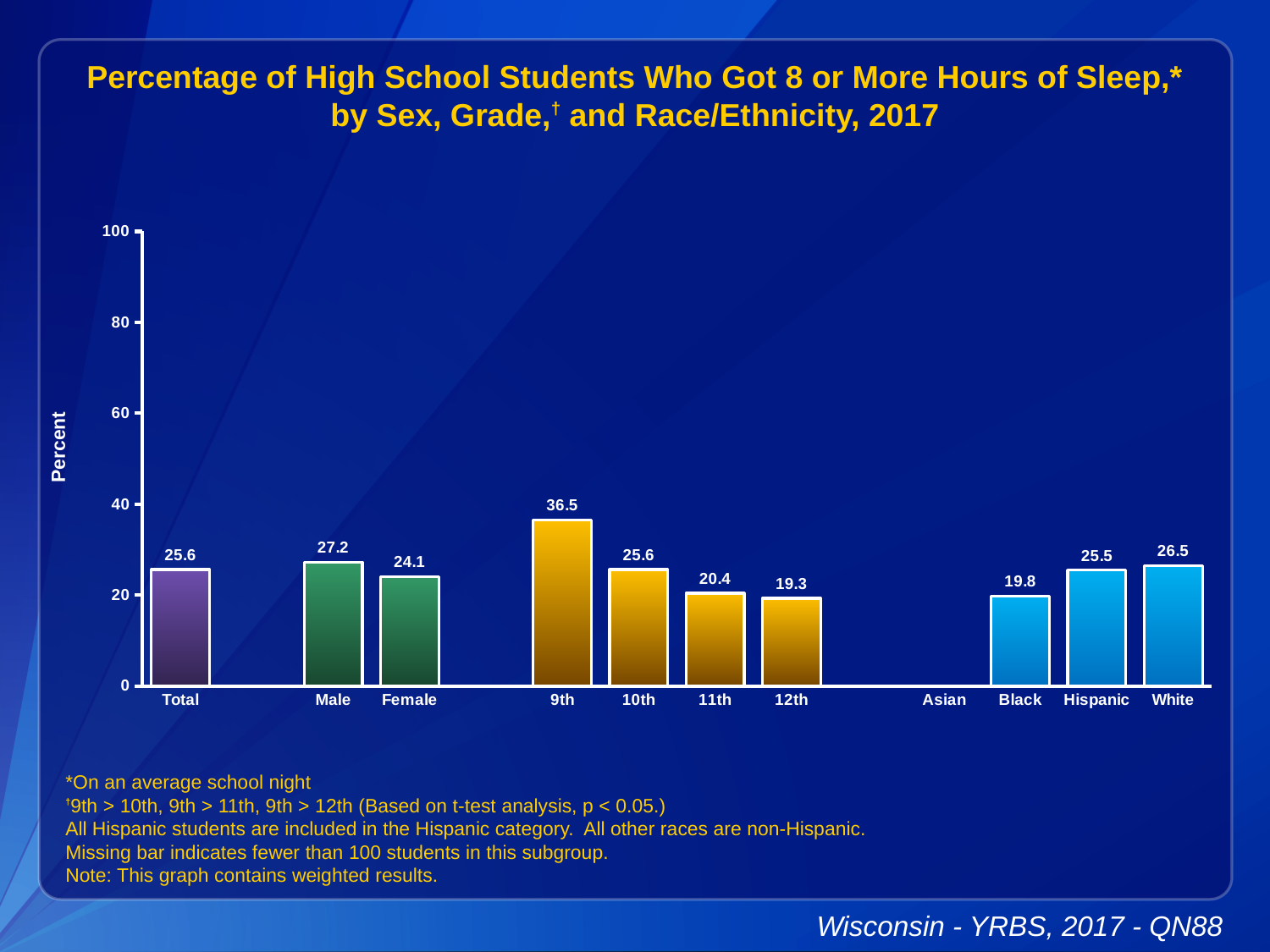
Do the values rise or fall from 9th grade to 12th grade? fall Is the value for 9th grade greater or less than 40? less What kind of chart is shown on the slide? bar chart Which race/ethnicity category has no bar shown? Asian Which grade has the lowest value? 12th What is the value for 9th grade students? 36.5 Which category has the highest value? 9th What is the value for Total? 25.6 What is the difference between the values for Male and Female? 3.1 Which is larger, the value for Hispanic or the value for White? White What is the value for Black students? 19.8 What is the difference between the values for 9th and 12th grade? 17.2